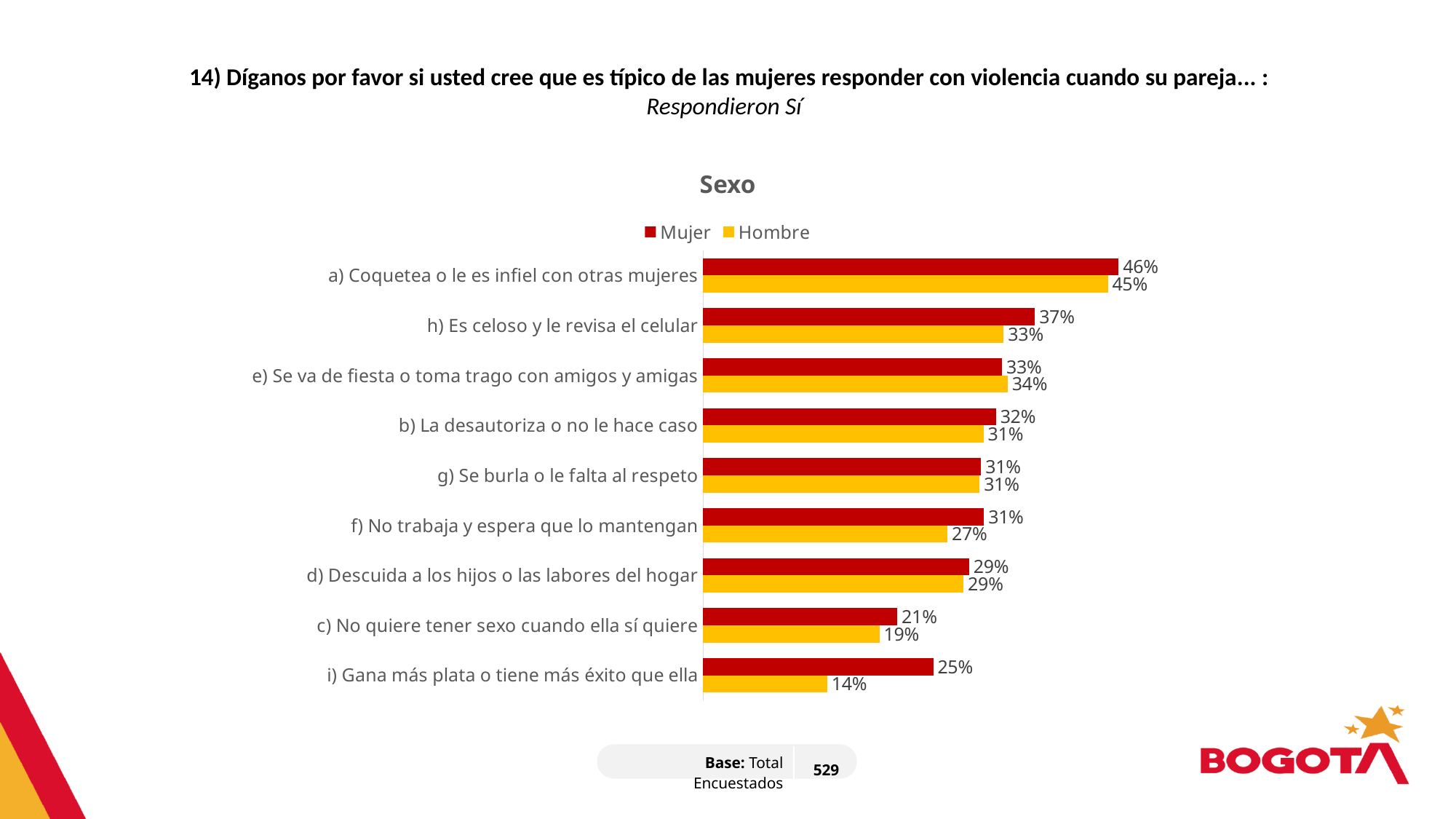
For 'f) No trabaja y espera que lo mantengan', which is larger, the Mujer value or the Hombre value? Mujer What is the difference between the Mujer values for 'h) Es celoso y le revisa el celular' and 'c) No quiere tener sexo cuando ella sí quiere'? 16% Which category has the highest Mujer value? a) Coquetea o le es infiel con otras mujeres What is the Hombre value for 'i) Gana más plata o tiene más éxito que ella'? 14% What is the Hombre value for 'h) Es celoso y le revisa el celular'? 33% What is the difference between the Mujer and Hombre values for 'i) Gana más plata o tiene más éxito que ella'? 11% How many series does the legend list? 2 What is the Mujer value for 'a) Coquetea o le es infiel con otras mujeres'? 46% How many categories are shown in the chart? 9 Which category has the lowest Hombre value? i) Gana más plata o tiene más éxito que ella What is the title shown above the legend of the chart? Sexo What type of chart is shown on the slide? bar chart